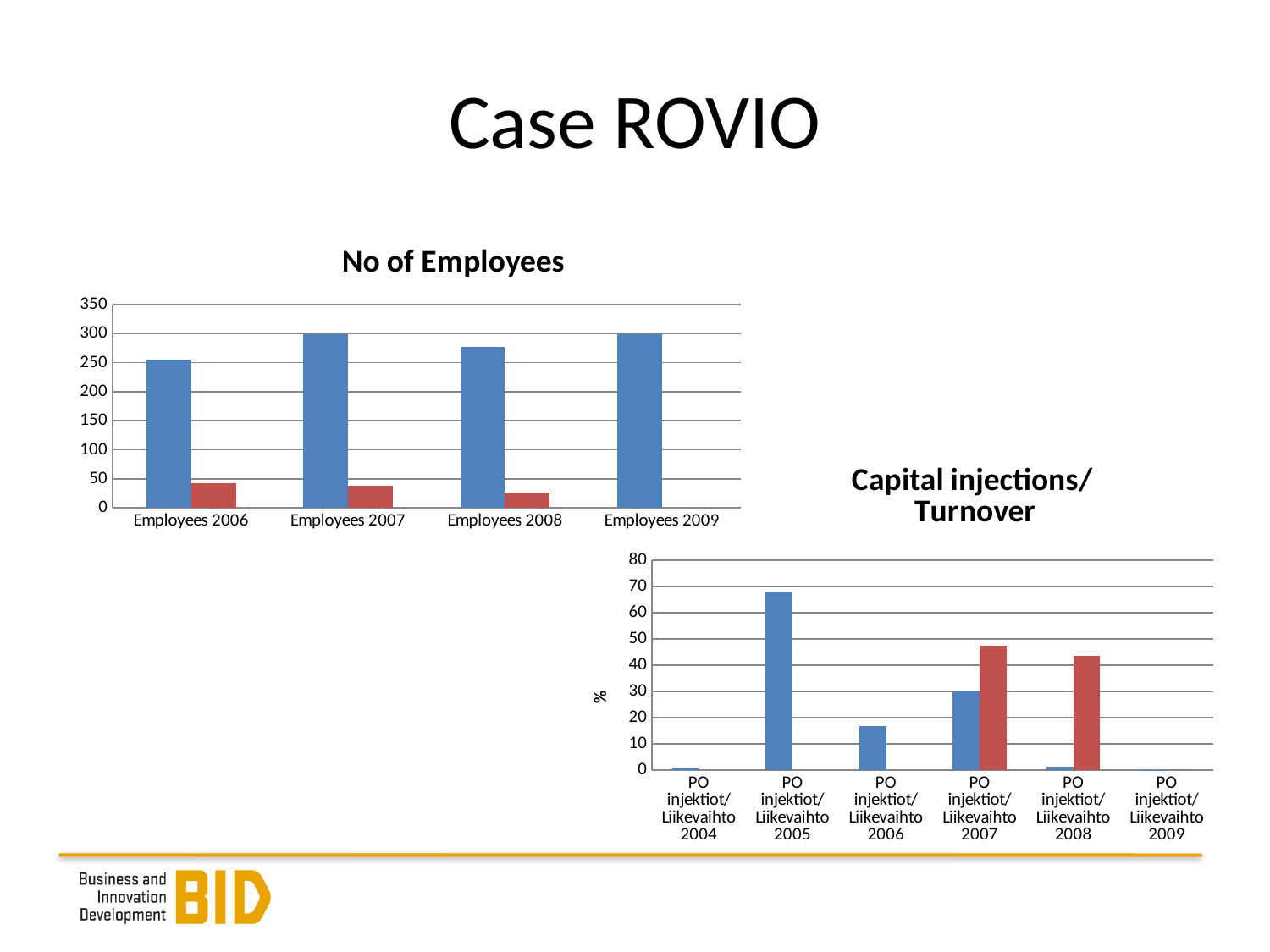
In the 'No of Employees' chart, is the blue bar for Employees 2006 greater or less than 200? greater In the 'No of Employees' chart, which is larger: the blue bar for Employees 2007 or the blue bar for Employees 2006? Employees 2007 In the 'Capital injections/Turnover' chart, is the blue bar for PO injektiot/Liikevaihto 2006 greater or less than 20? less In the 'No of Employees' chart, is the blue bar for Employees 2008 greater or less than 300? less What kind of chart is the 'No of Employees' chart? bar chart How many categories are shown on the x axis of the 'No of Employees' chart? 4 What is the label on the y axis of the 'Capital injections/Turnover' chart? % In the 'Capital injections/Turnover' chart, which category has the highest blue bar? PO injektiot/Liikevaihto 2005 In the 'No of Employees' chart, which category has the lowest blue bar? Employees 2006 How many categories are shown on the x axis of the 'Capital injections/Turnover' chart? 6